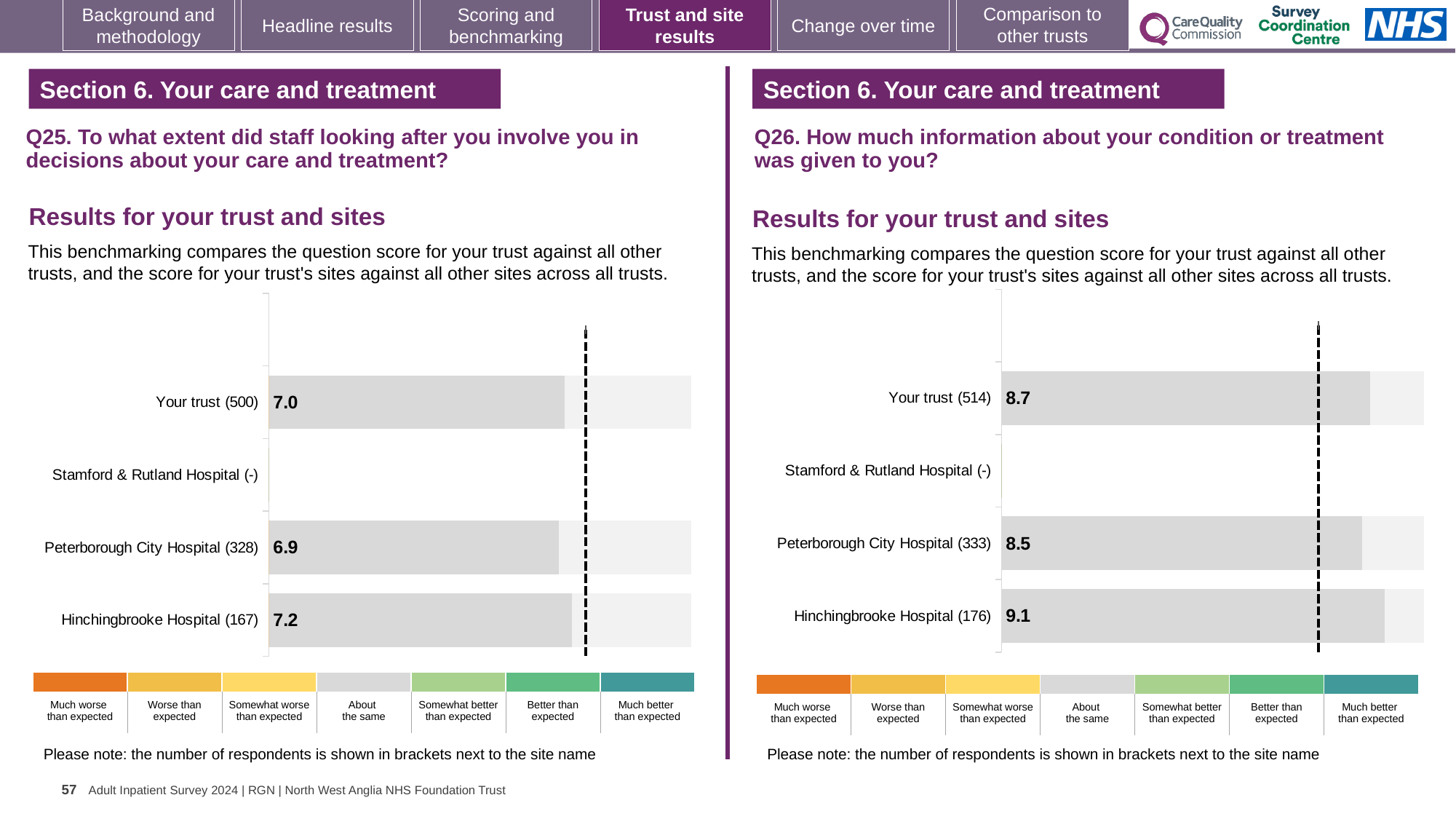
In the Q25 chart on the left, what is the score for Your trust? 7.0 In the Q26 chart on the right, which has the larger score, Your trust or Peterborough City Hospital? Your trust What type of chart is used for the Q26 results on the right? Bar chart In the Q25 chart on the left, what is the score for Peterborough City Hospital? 6.9 In the Q26 chart on the right, which site has the lowest score among those with a value shown? Peterborough City Hospital In the Q25 chart on the left, which site has the highest score? Hinchingbrooke Hospital In the Q25 chart on the left, what is the difference between the scores for Hinchingbrooke Hospital and Peterborough City Hospital? 0.3 In the Q25 chart on the left, how many respondents are shown in brackets for Your trust? 500 In the Q26 chart on the right, what is the score for Your trust? 8.7 How many row labels are listed on the Q25 chart on the left? 4 In the Q26 chart on the right, what is the difference between the scores for Hinchingbrooke Hospital and Your trust? 0.4 In the Q26 chart on the right, what is the score for Hinchingbrooke Hospital? 9.1